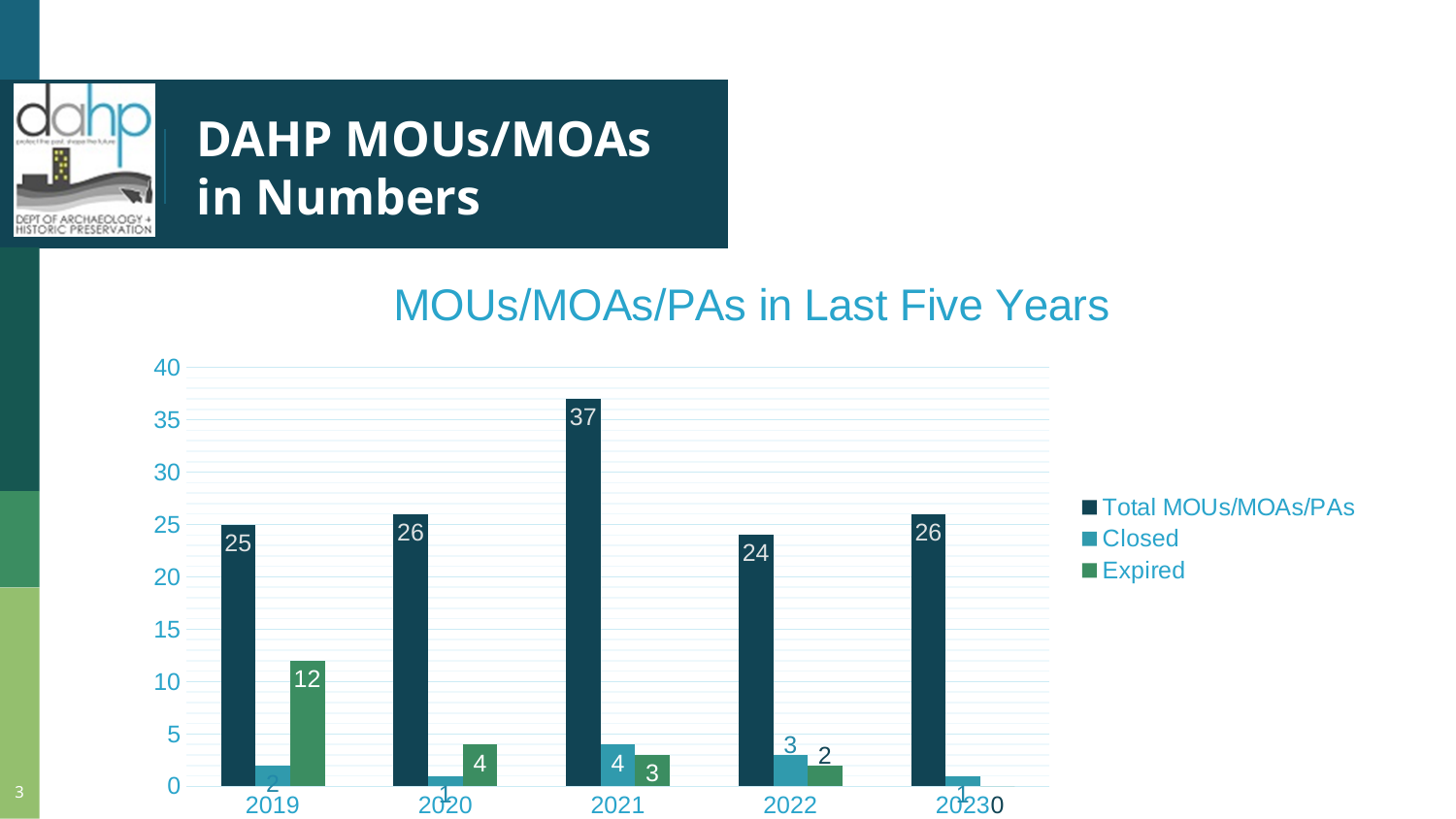
How many years are shown on the x axis? 5 Which year has the highest Total MOUs/MOAs/PAs? 2021 What is the Expired value for 2019? 12 What is the Closed value for 2022? 3 Which is larger, the Expired value for 2019 or the Expired value for 2020? 2019 What is the value for Total MOUs/MOAs/PAs in 2021? 37 What kind of chart is shown on the slide? bar chart How many series does the legend list? 3 Is the Total MOUs/MOAs/PAs value for 2021 greater or less than 35? greater Which year has the lowest Total MOUs/MOAs/PAs? 2022 What is the difference between the Total MOUs/MOAs/PAs in 2021 and in 2022? 13 What is the title of the chart? MOUs/MOAs/PAs in Last Five Years